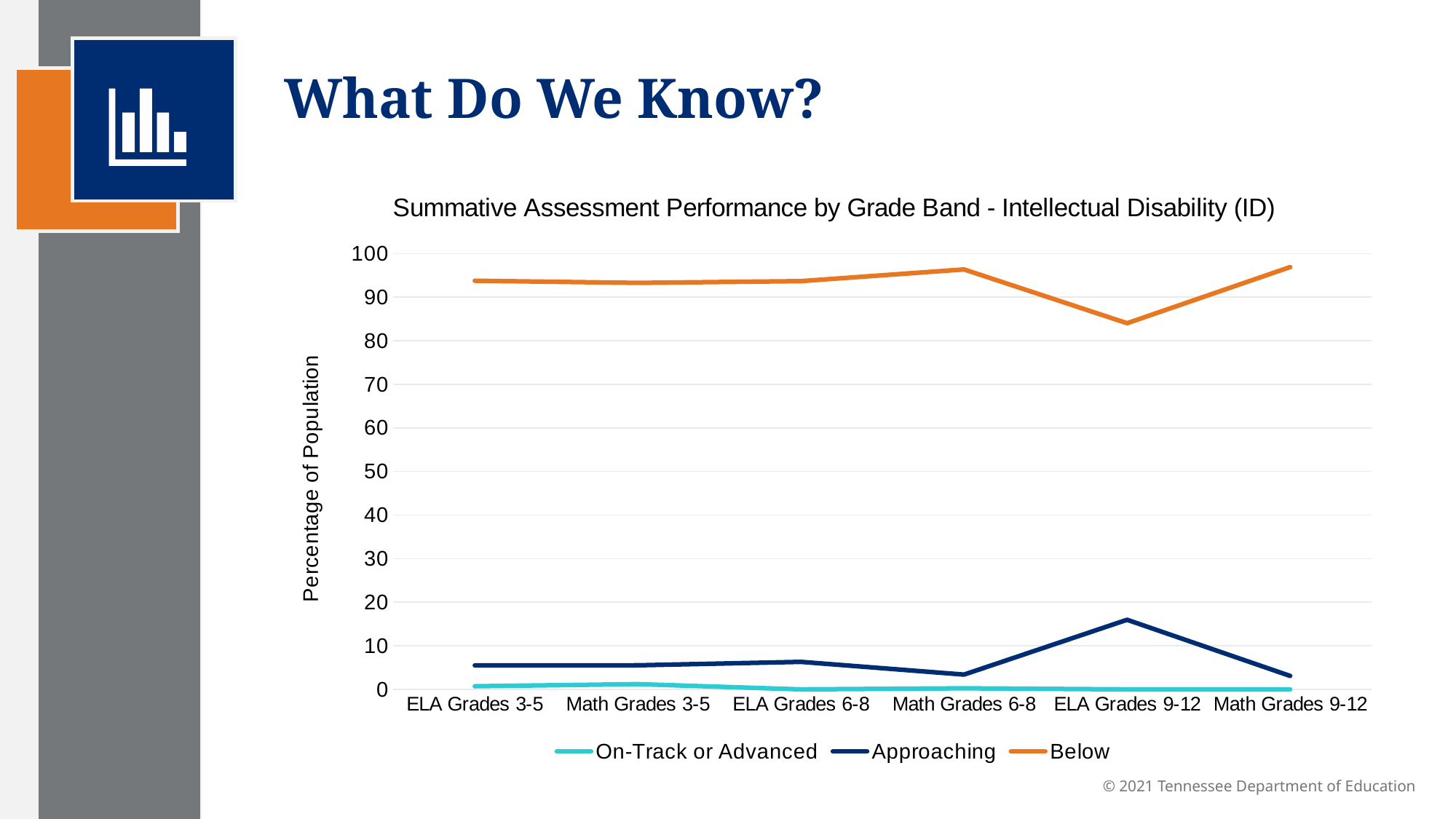
Is the Approaching value for ELA Grades 9-12 greater or less than 10? greater Is the Approaching value for Math Grades 6-8 greater or less than 10? less What kind of chart is shown on the slide? line chart How many grade-band categories are shown on the x axis? 6 Does the Approaching series rise or fall from ELA Grades 9-12 to Math Grades 9-12? fall For the Approaching series, which category has the highest value? ELA Grades 9-12 Is the Below value for Math Grades 9-12 greater or less than 90? greater For the Below series, which category has the lowest value? ELA Grades 9-12 What is the label on the vertical axis of the chart? Percentage of Population Which is larger for the Below series: ELA Grades 9-12 or Math Grades 9-12? Math Grades 9-12 How many series does the legend list? 3